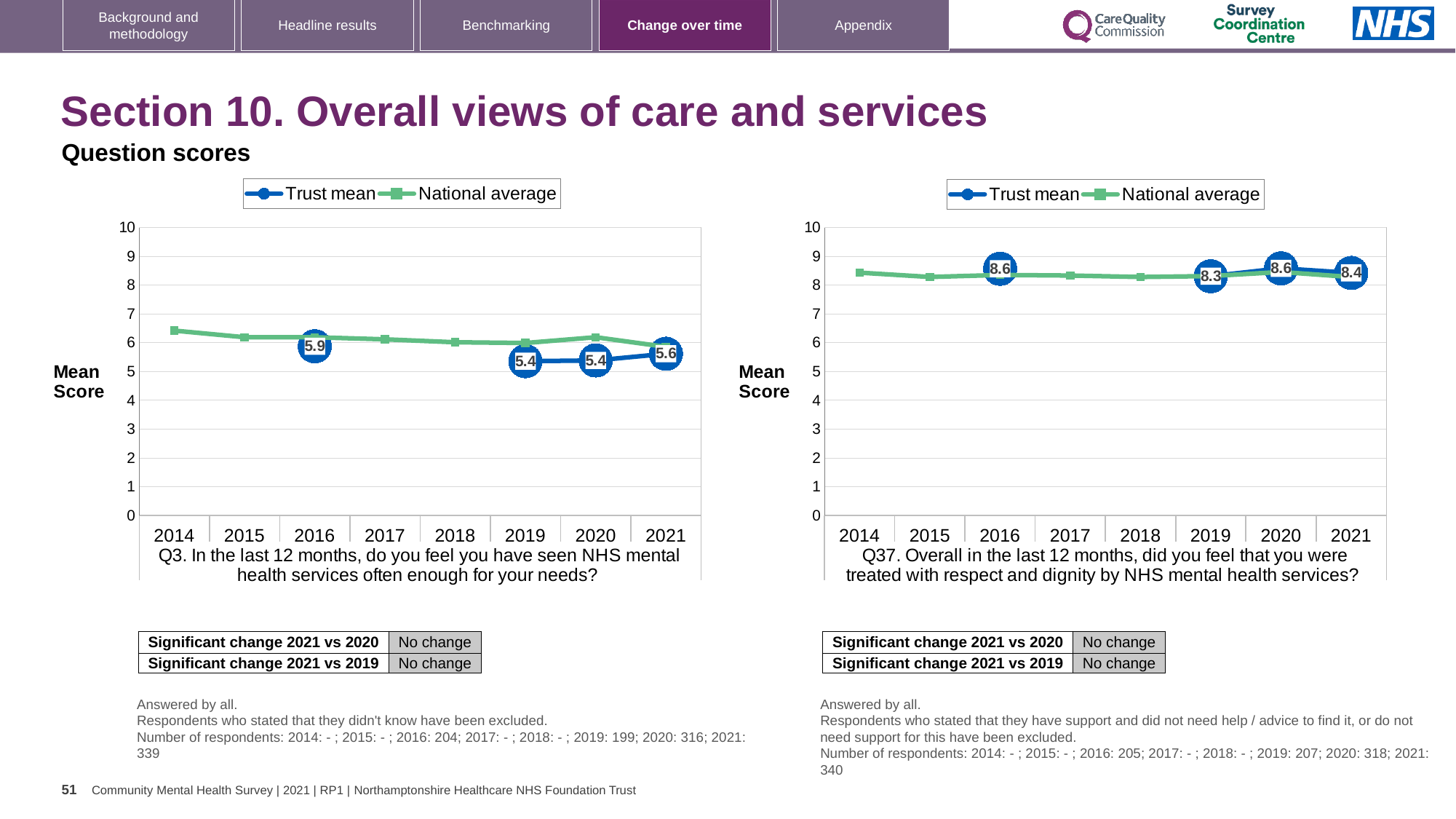
In the right chart (Q37), which year has the lowest labelled Trust mean? 2019 In the left chart (Q3), is the National average for 2014 greater or less than 6? greater In the right chart (Q37), is the Trust mean for 2020 larger or smaller than the Trust mean for 2021? larger In the left chart (Q3), what is the Trust mean for 2016? 5.9 In the left chart (Q3), which year has the highest labelled Trust mean? 2016 In the right chart (Q37), what is the Trust mean for 2019? 8.3 How many years are shown on the x axis of the right chart (Q37)? 8 How many series does the legend of the left chart (Q3) list? 2 In the right chart (Q37), what is the Trust mean for 2021? 8.4 What type of chart is the right chart (Q37)? Line chart In the left chart (Q3), what is the difference between the Trust mean in 2016 and in 2019? 0.5 In the left chart (Q3), what is the Trust mean for 2021? 5.6